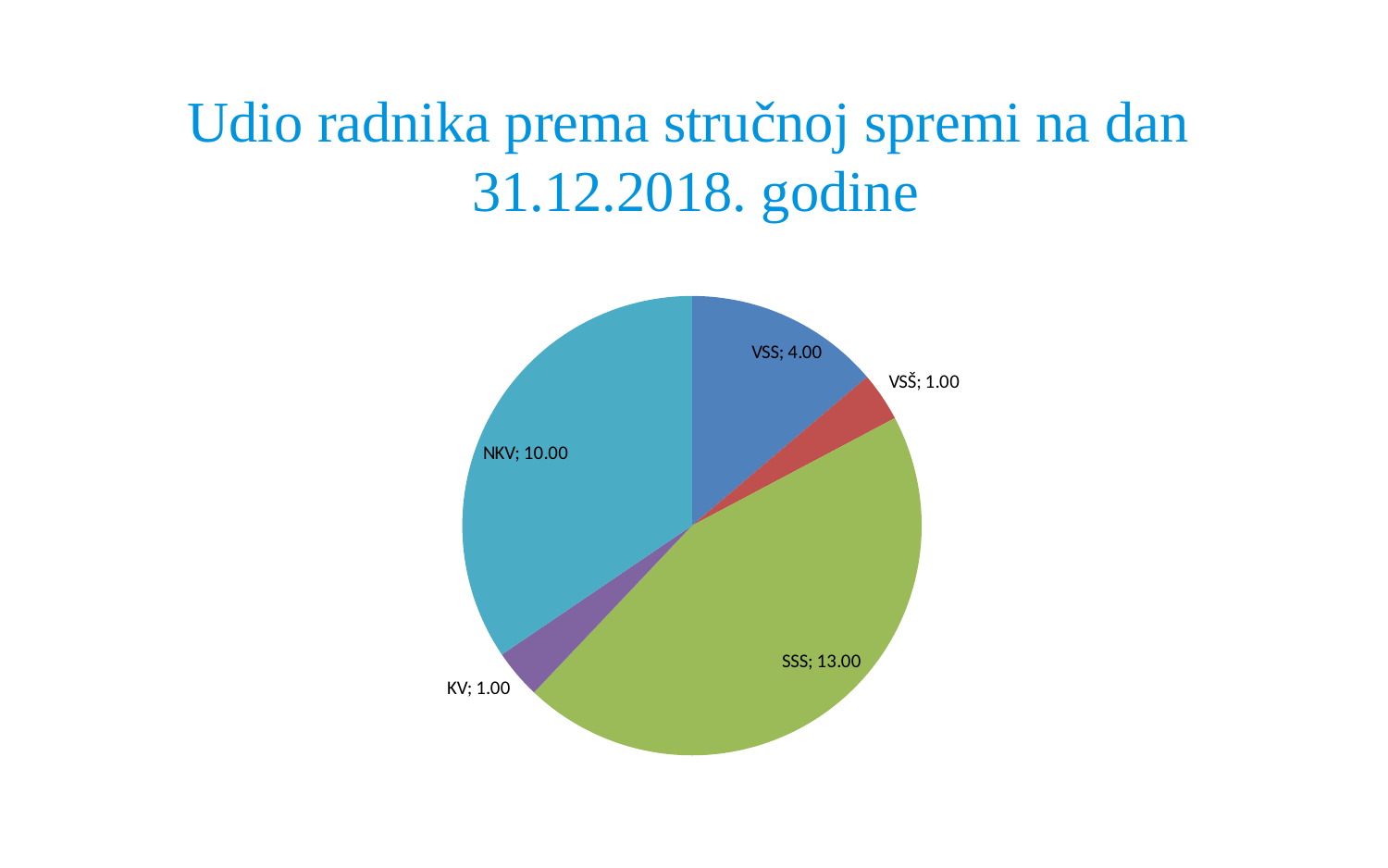
What is the value for SSS? 13.00 Which is larger, the value for NKV or the value for VSS? NKV Which category has the largest slice of the pie? SSS Which two categories share the smallest value in the pie? VSŠ and KV What is the value for NKV? 10.00 What is the value for VSS? 4.00 How many slices does the pie chart have? 5 What type of chart is shown on the slide? pie chart What is the title of the slide containing the chart? Udio radnika prema stručnoj spremi na dan 31.12.2018. godine What is the difference between the values for VSS and VSŠ? 3.00 What is the value for KV? 1.00 What is the difference between the values for SSS and NKV? 3.00